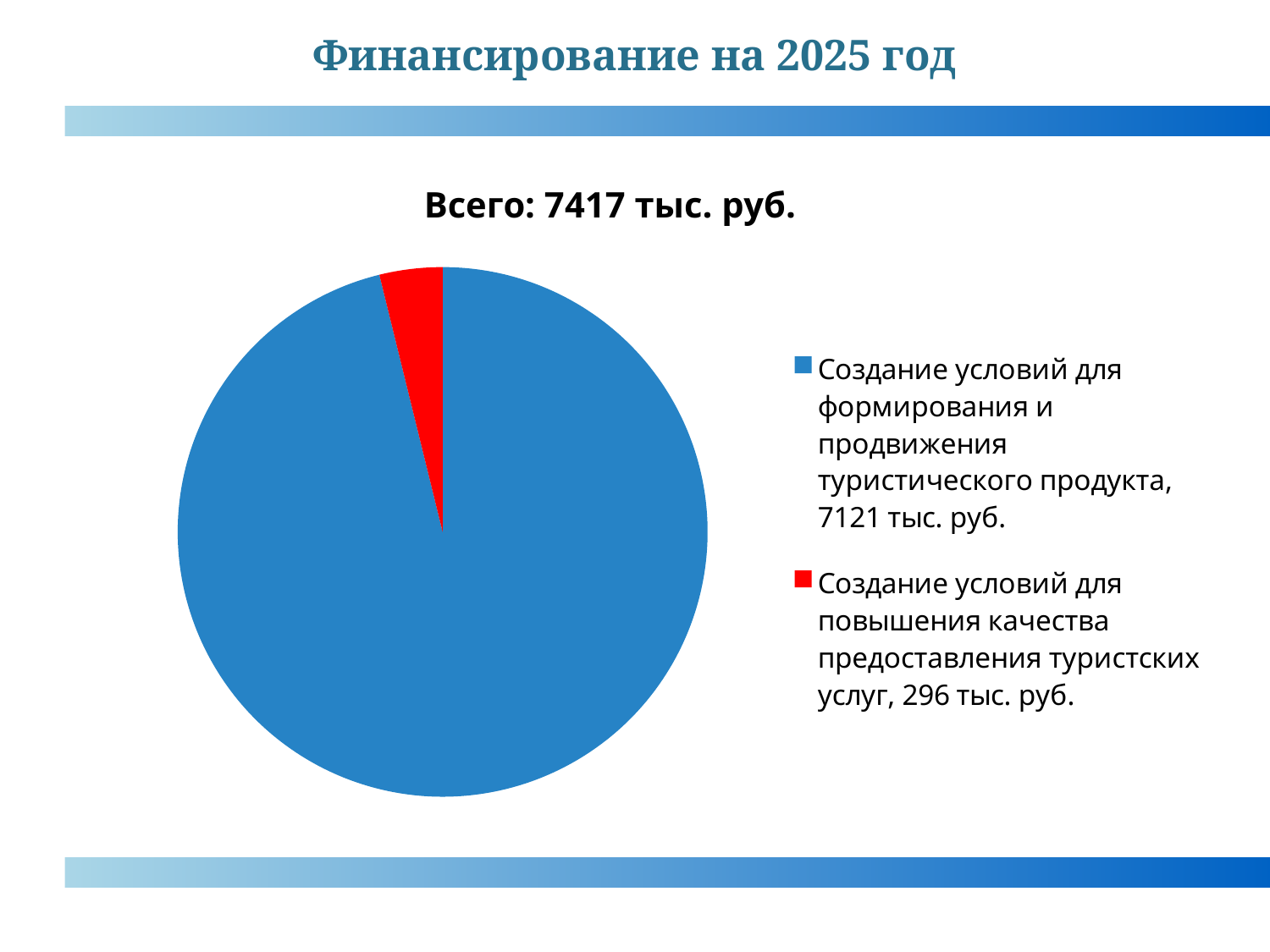
How many categories does the pie chart have? 2 What colour is the slice for "Создание условий для повышения качества предоставления туристских услуг"? red What is the difference between the two categories' values? 6825 тыс. руб. Which category has the smallest slice of the pie? Создание условий для повышения качества предоставления туристских услуг Which category has the largest slice of the pie? Создание условий для формирования и продвижения туристического продукта What is the value for "Создание условий для формирования и продвижения туристического продукта"? 7121 тыс. руб. Which is larger: the value for "Создание условий для формирования и продвижения туристического продукта" or for "Создание условий для повышения качества предоставления туристских услуг"? Создание условий для формирования и продвижения туристического продукта What kind of chart is shown on the slide? pie chart What is the total amount shown in the chart title? 7417 тыс. руб. How many entries does the legend list? 2 What is the value for "Создание условий для повышения качества предоставления туристских услуг"? 296 тыс. руб.